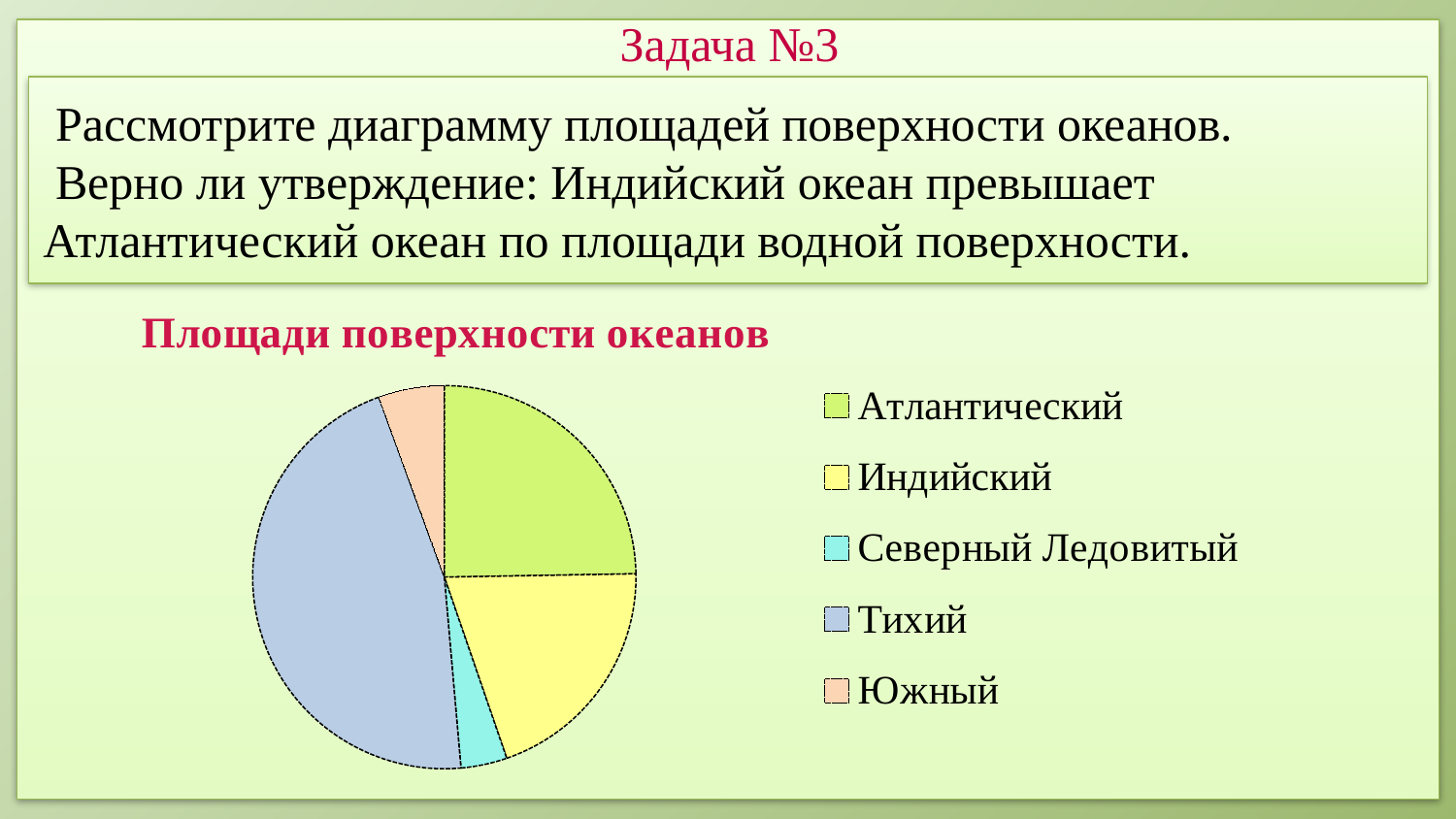
Which slice is larger, Атлантический or Индийский? Атлантический Which ocean has the largest slice in the pie chart? Тихий Which legend entry is shown in yellow? Индийский Which slice is larger, Индийский or Северный Ледовитый? Индийский Which slice is larger, Тихий or Атлантический? Тихий How many slices does the pie chart have? 5 How many entries does the legend list? 5 What is the title of the chart? Площади поверхности океанов What kind of chart is shown on the slide? pie chart